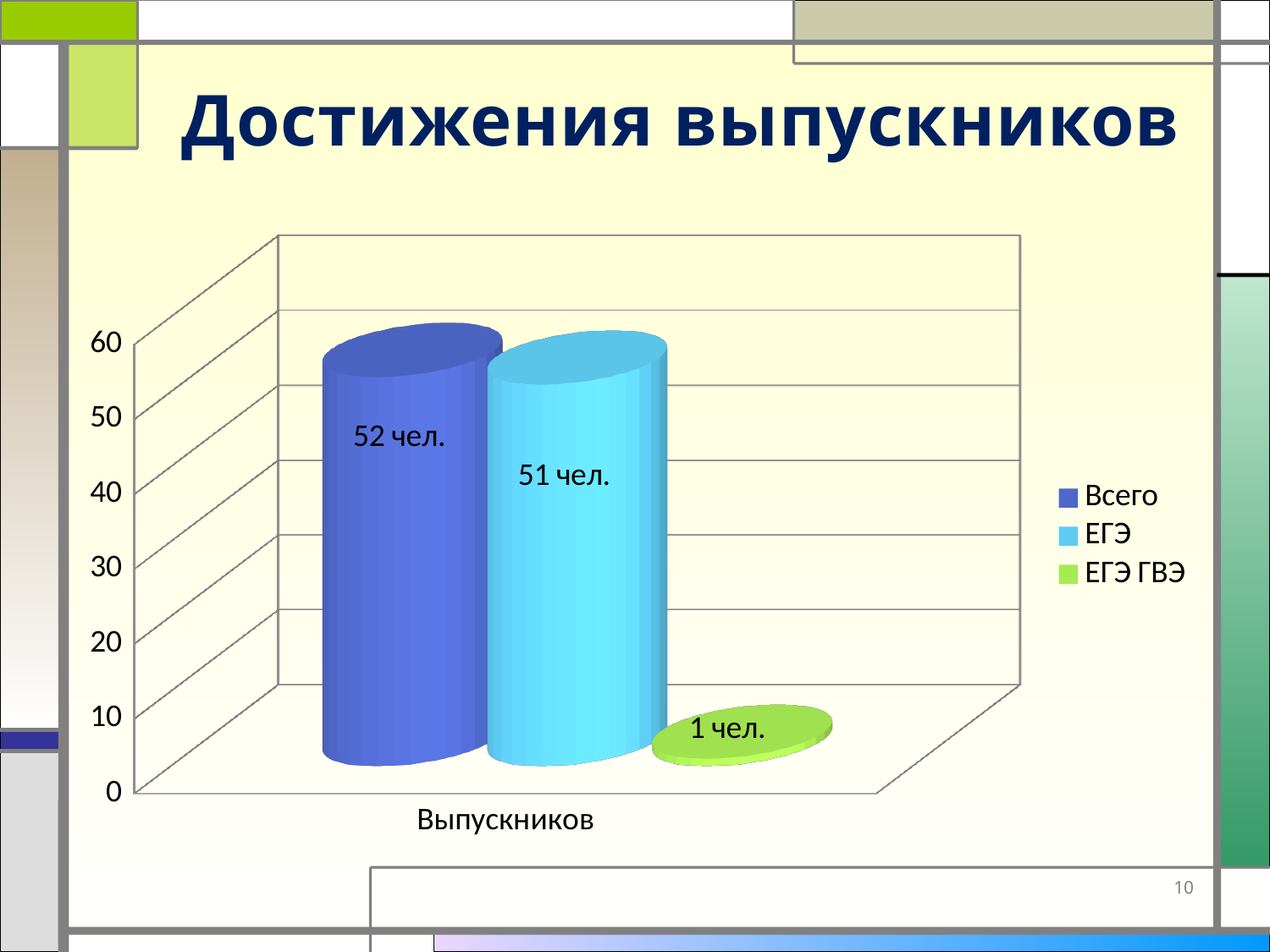
Is the value for Всего greater or less than 40? greater What kind of chart is shown on the slide? bar chart Which series has the lowest value? ЕГЭ ГВЭ How many series does the legend list? 3 What is the value for the Всего series? 52 чел. What is the title of the slide? Достижения выпускников Which is larger, the value for ЕГЭ or the value for ЕГЭ ГВЭ? ЕГЭ What is the difference between the Всего value and the ЕГЭ value? 1 чел. Which series has the highest value? Всего What is the value for the ЕГЭ series? 51 чел. What is the value for the ЕГЭ ГВЭ series? 1 чел. What is the difference between the ЕГЭ value and the ЕГЭ ГВЭ value? 50 чел.